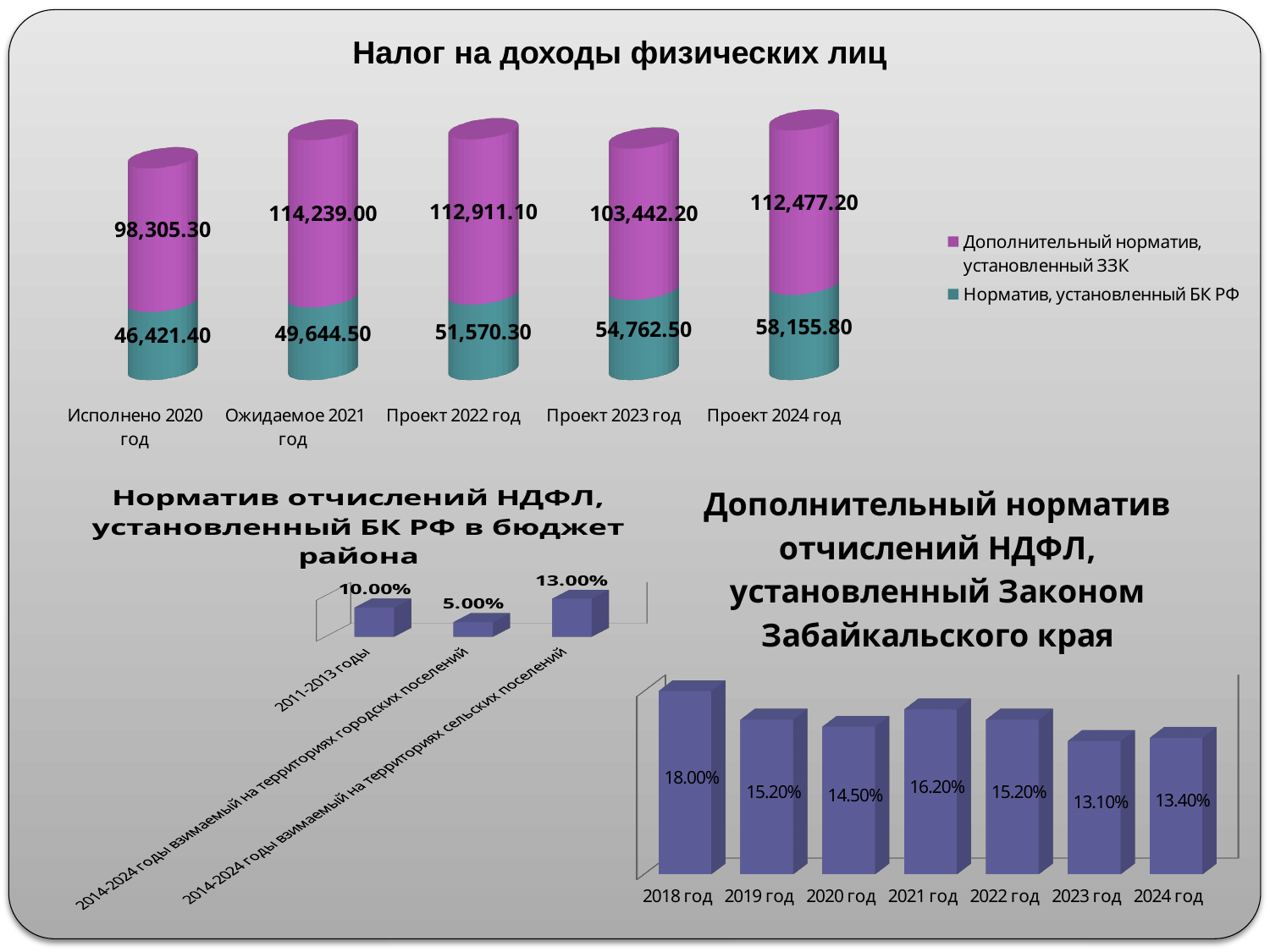
In the bottom-right chart titled "Дополнительный норматив отчислений НДФЛ, установленный Законом Забайкальского края", which year has the highest value? 2018 год In the chart titled "Налог на доходы физических лиц", what is the difference between the "Норматив, установленный БК РФ" values for "Проект 2024 год" and "Проект 2023 год"? 3,393.30 In the chart titled "Налог на доходы физических лиц", does the "Норматив, установленный БК РФ" series rise or fall from left to right? rise In the bottom-left chart titled "Норматив отчислений НДФЛ, установленный БК РФ в бюджет района", what is the value for "2011-2013 годы"? 10.00% In the chart titled "Налог на доходы физических лиц", how many series does the legend list? 2 In the chart titled "Налог на доходы физических лиц", what is the value of "Норматив, установленный БК РФ" for "Исполнено 2020 год"? 46,421.40 In the chart titled "Налог на доходы физических лиц", which category has the highest value for "Дополнительный норматив, установленный ЗЗК"? Ожидаемое 2021 год In the chart titled "Налог на доходы физических лиц", what is the value of "Дополнительный норматив, установленный ЗЗК" for "Проект 2022 год"? 112,911.10 In the chart titled "Налог на доходы физических лиц", what is the total of the stacked bar for "Проект 2024 год"? 170,633.00 In the chart titled "Налог на доходы физических лиц", which category has the lowest value for "Норматив, установленный БК РФ"? Исполнено 2020 год In the bottom-right chart titled "Дополнительный норматив отчислений НДФЛ, установленный Законом Забайкальского края", what is the value for "2021 год"? 16.20% In the bottom-left chart titled "Норматив отчислений НДФЛ, установленный БК РФ в бюджет района", how many categories are shown? 3